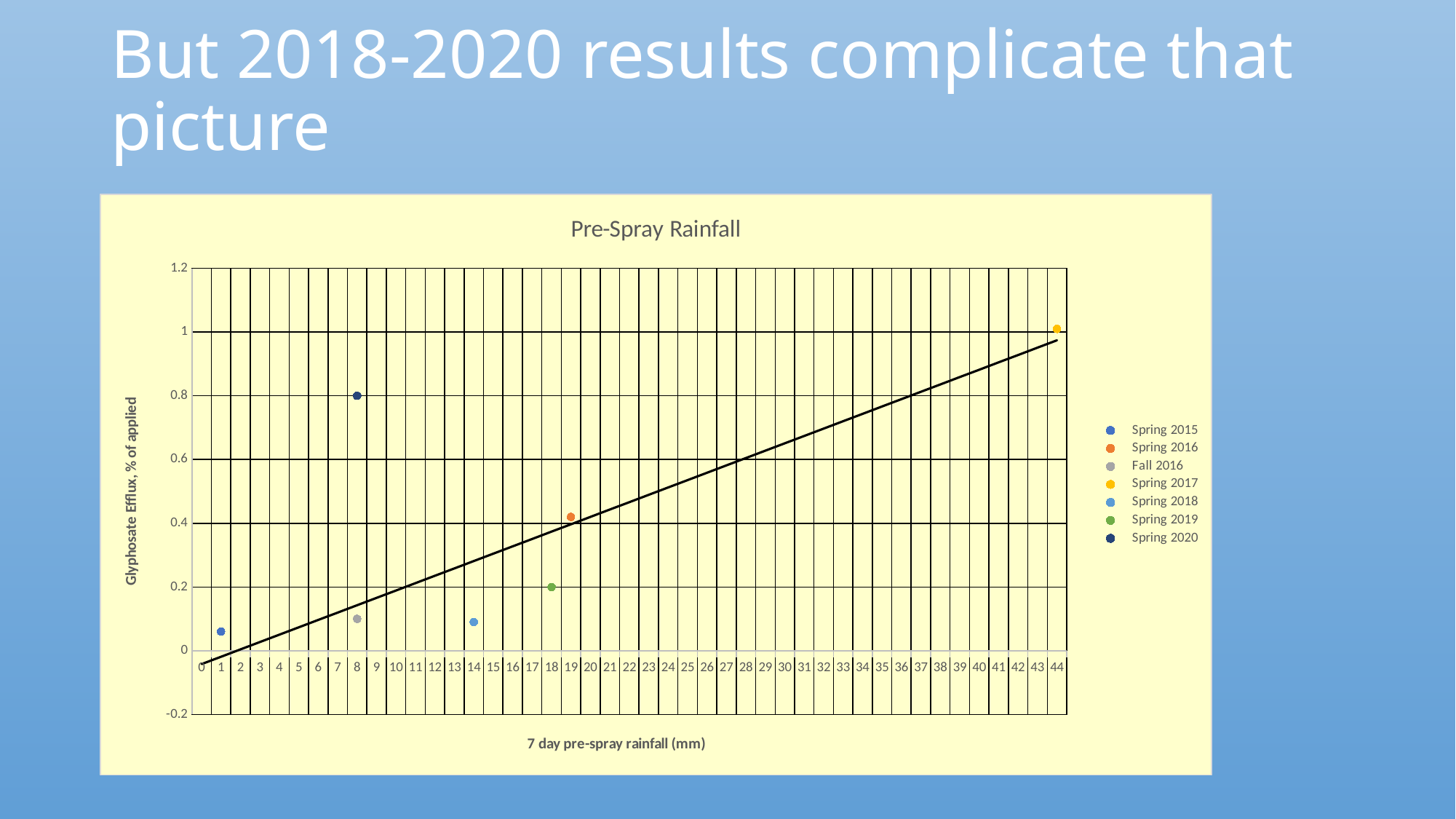
Is the glyphosate efflux value for Spring 2020 greater or less than 0.6? greater Does the fitted trend line rise or fall as 7 day pre-spray rainfall increases? Rises How many series does the legend list? 7 What kind of chart is shown on the slide? Scatter chart How many data points are plotted on the chart? 7 What is the label of the x axis? 7 day pre-spray rainfall (mm) Is the glyphosate efflux value for Spring 2019 greater or less than 0.4? less Is the glyphosate efflux value for Spring 2016 greater or less than 0.2? greater Which series has the highest glyphosate efflux value? Spring 2017 What is the title of the chart? Pre-Spray Rainfall Which has a higher glyphosate efflux value, Spring 2020 or Spring 2016? Spring 2020